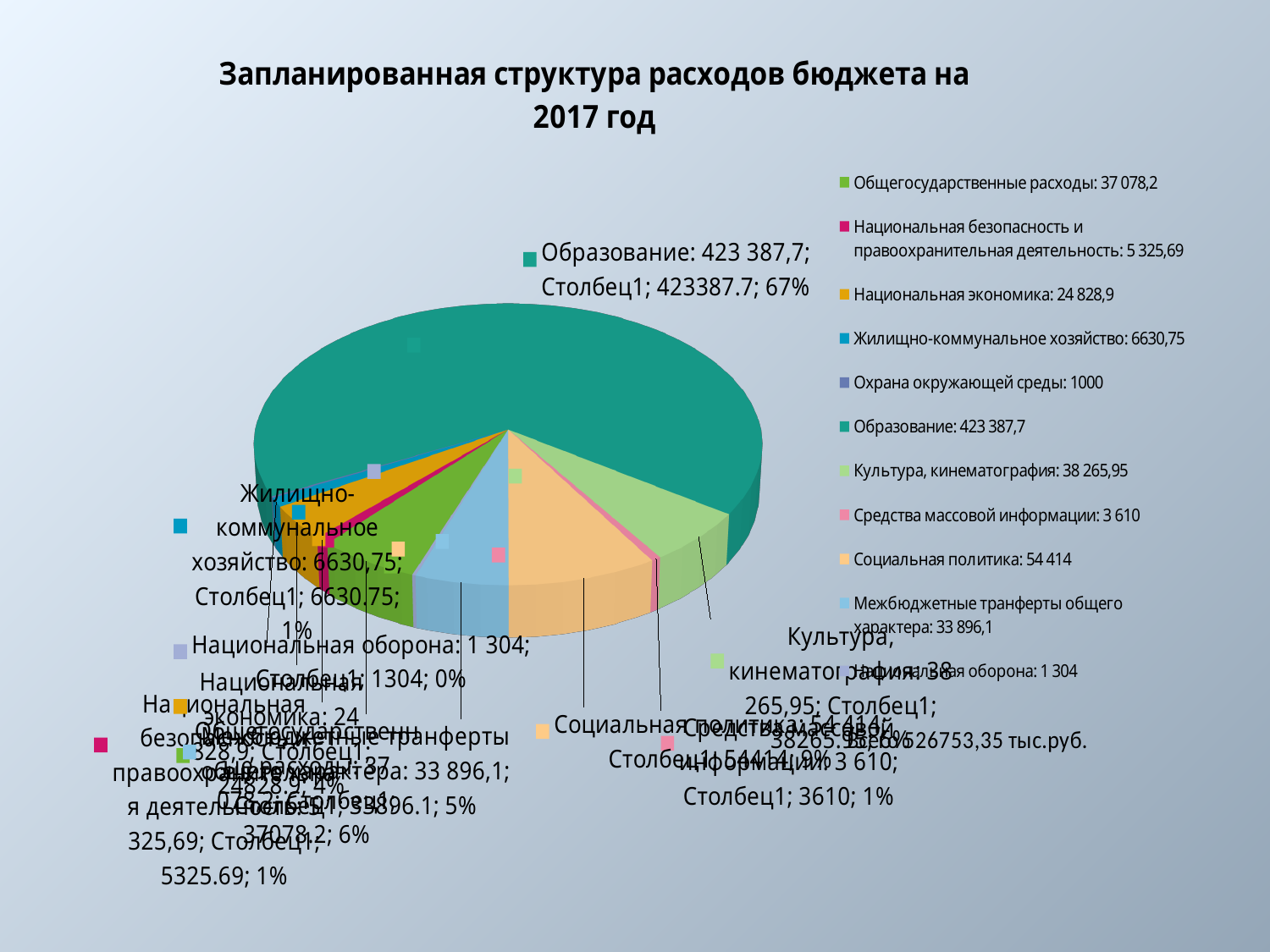
What is the value shown for Социальная политика in the legend? 54 414 What percentage is shown for Социальная политика? 9% What is the value shown for Образование in the legend? 423 387,7 Which is larger, Культура, кинематография or Национальная экономика? Культура, кинематография What is the value shown for Охрана окружающей среды in the legend? 1000 What share of the pie does Образование account for? 67% What kind of chart is shown on the slide? pie chart What total amount is stated on the slide (Всего)? 626753,35 тыс.руб. What percentage is shown for Межбюджетные трансферты общего характера? 5% How many categories does the legend list? 11 Which category has the largest share of the pie? Образование What is the title of the chart? Запланированная структура расходов бюджета на 2017 год